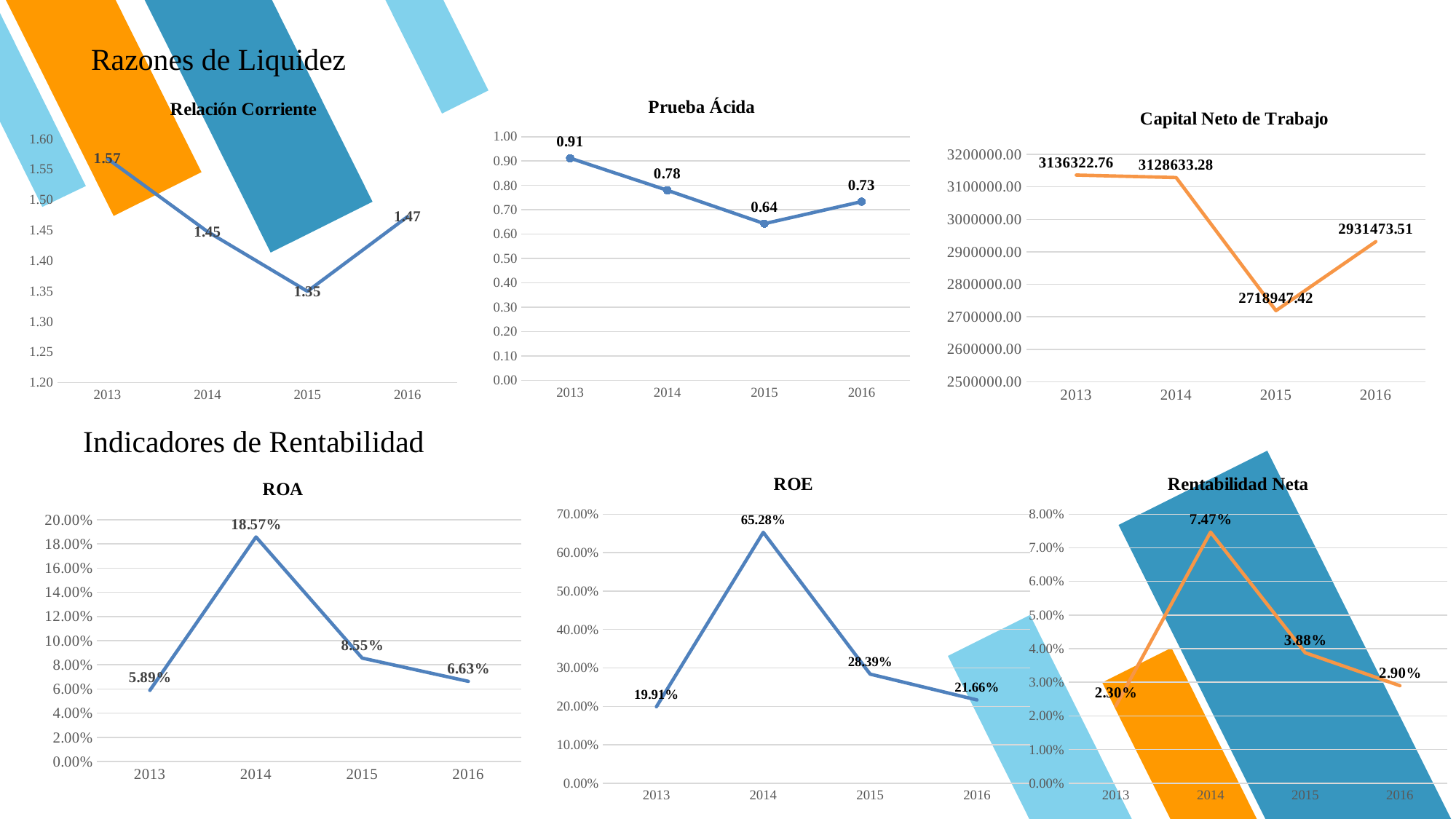
In the Prueba Ácida chart, what is the difference between the 2013 and 2015 values? 0.27 In the Relación Corriente chart, what is the value for 2015? 1.35 In the Capital Neto de Trabajo chart, which year has the lowest value? 2015 In the ROE chart, is the value for 2016 greater or less than 30.00%? less In the ROA chart, what is the value for 2014? 18.57% In the ROA chart, which is larger, the value for 2013 or the value for 2016? 2016 In the Rentabilidad Neta chart, what is the value for 2013? 2.30% What kind of chart is the Relación Corriente chart? line chart How many years are plotted on the x axis of the Rentabilidad Neta chart? 4 In the Prueba Ácida chart, which year has the highest value? 2013 In the Capital Neto de Trabajo chart, what is the value for 2016? 2931473.51 In the ROE chart, what is the difference between the 2014 and 2015 values? 36.89%